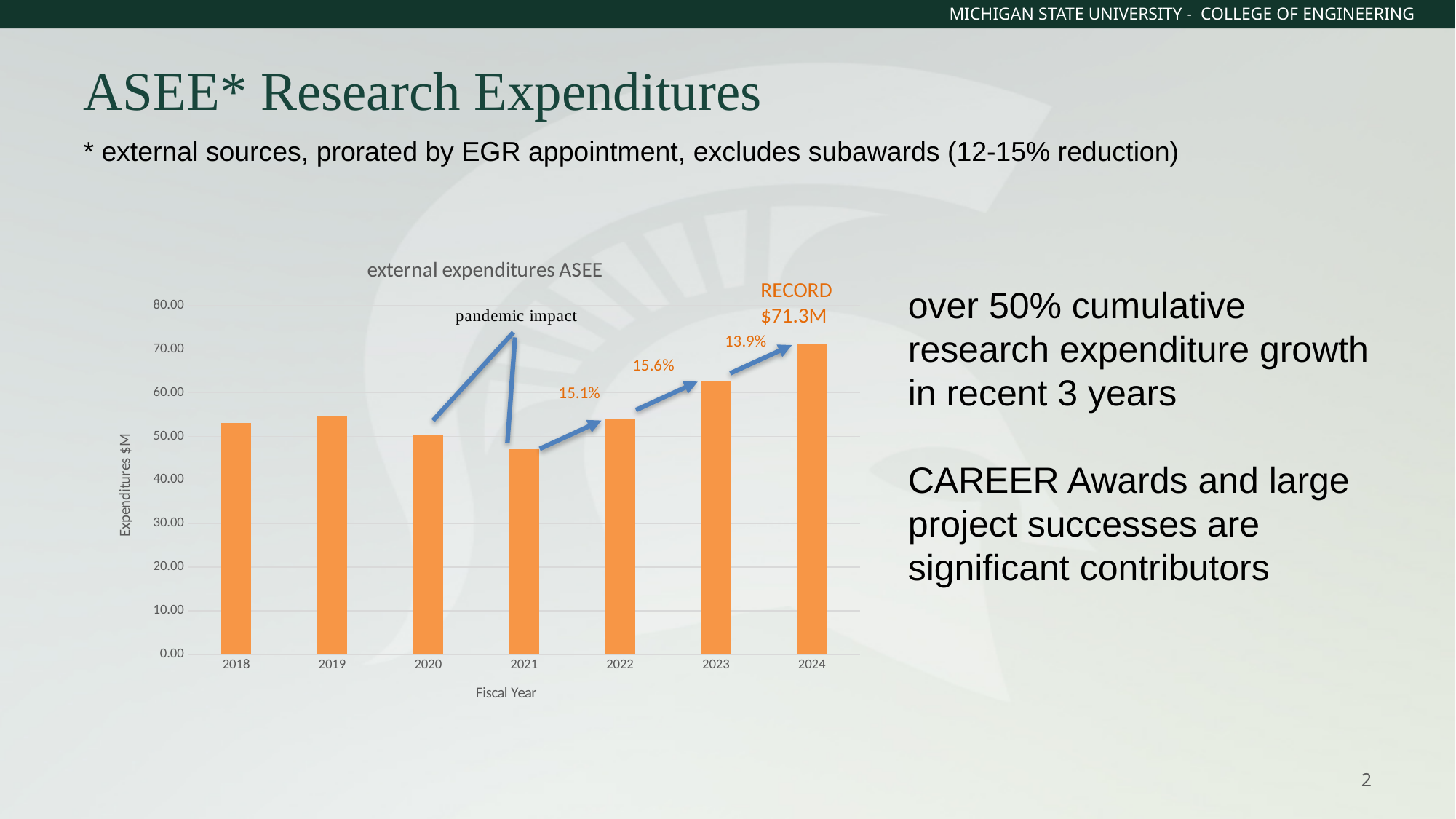
What is the title of the chart? external expenditures ASEE What kind of chart is shown on the slide? bar chart Is the value for 2018 greater or less than 50.00? greater Do the expenditures rise or fall from 2021 to 2024? rise How many fiscal years are plotted in the chart? 7 Is the value for 2023 greater or less than 60.00? greater Which fiscal year has the highest expenditures in the chart? 2024 Which is larger, the value for 2019 or the value for 2020? 2019 What growth percentage is labelled between 2022 and 2023? 15.6% Which fiscal year has the lowest expenditures in the chart? 2021 Is the value for 2021 greater or less than 50.00? less What is the record expenditure value labelled for 2024? $71.3M